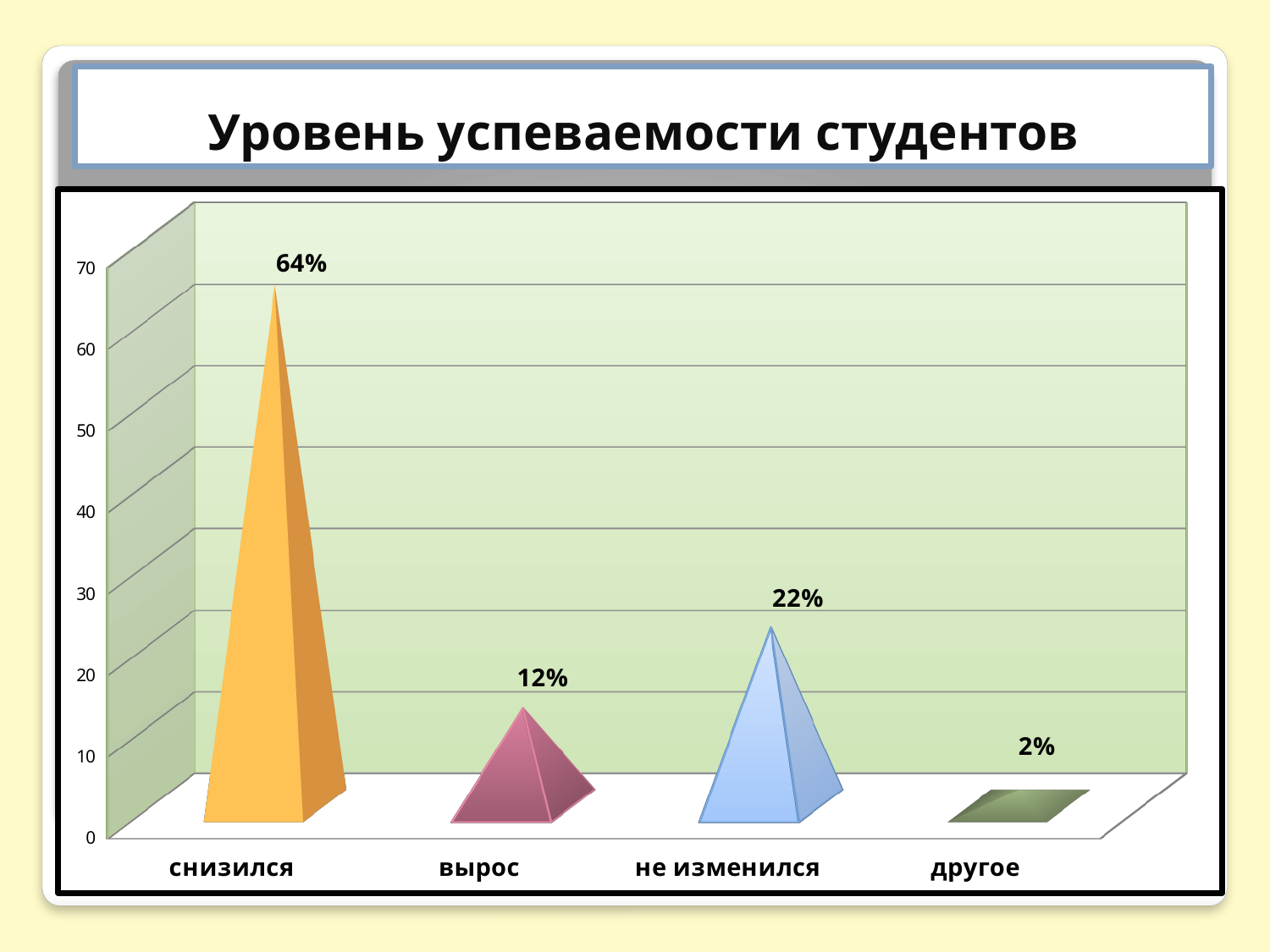
What is the difference between the values for не изменился and вырос? 10% What is the title of the chart? Уровень успеваемости студентов What kind of chart is shown on the slide? bar chart Which category has the highest value? снизился What is the value for снизился? 64% What is the difference between the values for снизился and не изменился? 42% What is the value for не изменился? 22% Which category has the lowest value? другое What is the value for вырос? 12% Which is larger, the value for вырос or the value for не изменился? не изменился What is the value for другое? 2% How many categories are shown on the x axis? 4